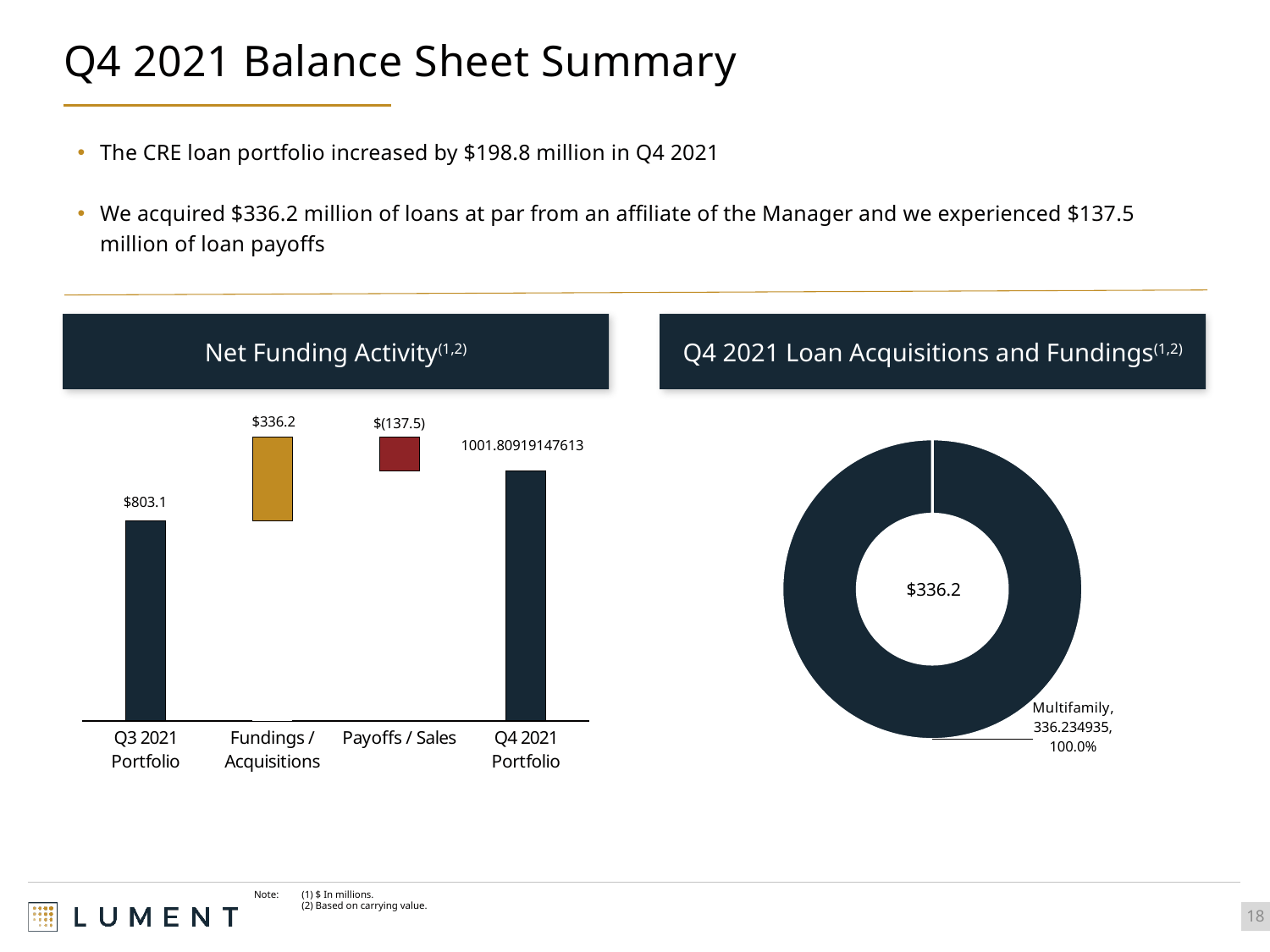
What kind of chart is the Q4 2021 Loan Acquisitions and Fundings chart? Donut chart In the Net Funding Activity chart, what is the value for Payoffs / Sales? $(137.5) In the Q4 2021 Loan Acquisitions and Fundings chart, what value is shown in the centre of the donut? $336.2 In the Net Funding Activity chart, what colour is the Fundings / Acquisitions bar? Gold What kind of chart is the Net Funding Activity chart? Bar chart In the Q4 2021 Loan Acquisitions and Fundings chart, what share does Multifamily represent? 100.0% In the Net Funding Activity chart, how many categories are shown on the x axis? 4 In the Net Funding Activity chart, which is larger: the Q3 2021 Portfolio or the Q4 2021 Portfolio? Q4 2021 Portfolio In the Net Funding Activity chart, what is the value for Fundings / Acquisitions? $336.2 In the Net Funding Activity chart, what is the difference between the Fundings / Acquisitions value and the absolute Payoffs / Sales value? $198.7 In the Net Funding Activity chart, what data label is shown for the Q4 2021 Portfolio? 1001.80919147613 In the Net Funding Activity chart, what is the value for the Q3 2021 Portfolio? $803.1